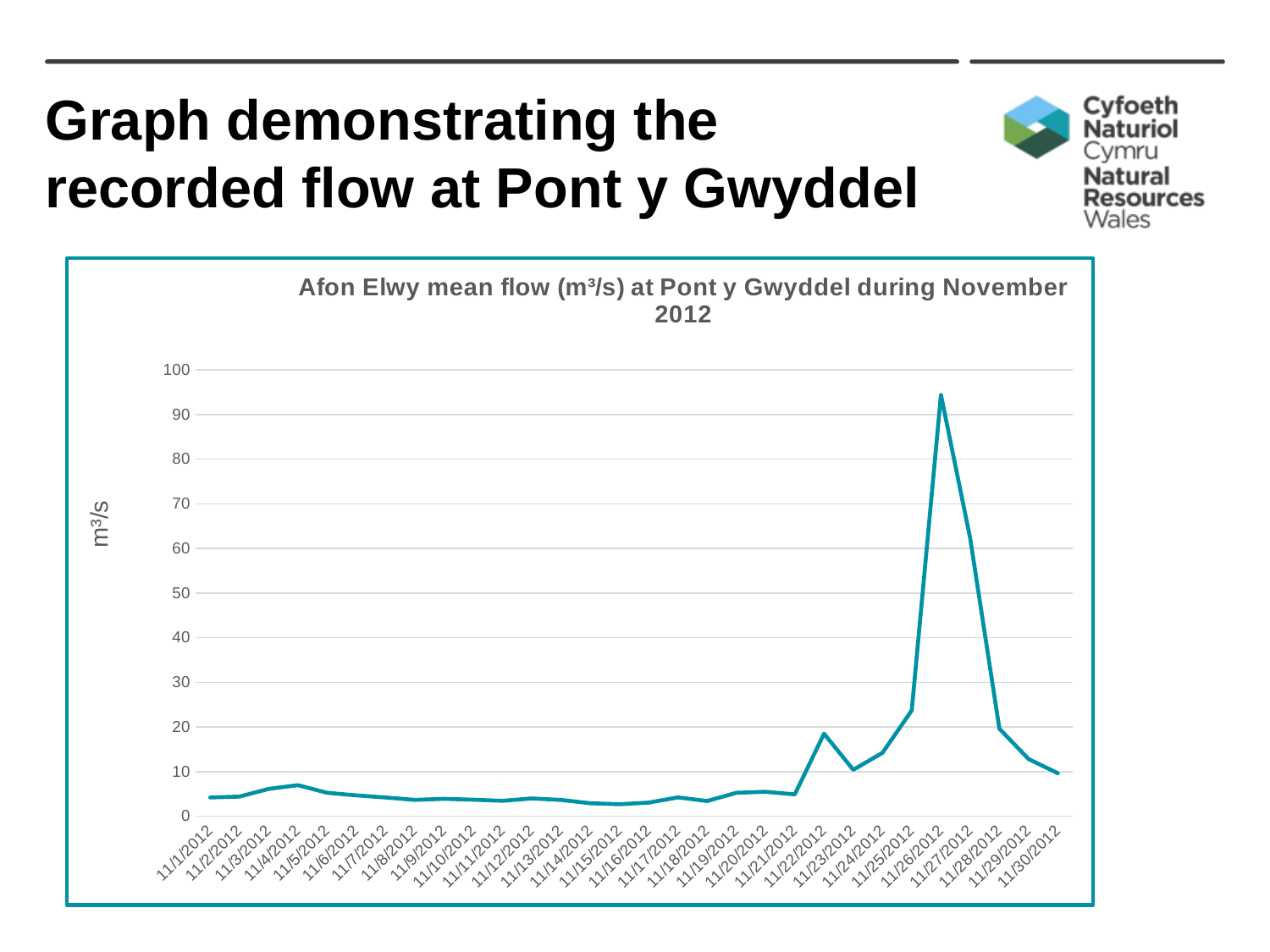
Is the value for 11/22/2012 greater or less than 10? greater Is the value for 11/1/2012 greater or less than 10? less Is the value for 11/26/2012 greater or less than 90? greater Which date has the larger mean flow, 11/22/2012 or 11/23/2012? 11/22/2012 Which date has the larger mean flow, 11/25/2012 or 11/28/2012? 11/25/2012 What is the title of the chart? Afon Elwy mean flow (m³/s) at Pont y Gwyddel during November 2012 What is the label on the vertical axis of the chart? m³/s How many dates are plotted along the x axis of the chart? 30 On which date does the mean flow reach its highest value? 11/26/2012 What kind of chart is shown on the slide? line chart Does the mean flow rise or fall between 11/26/2012 and 11/30/2012? fall